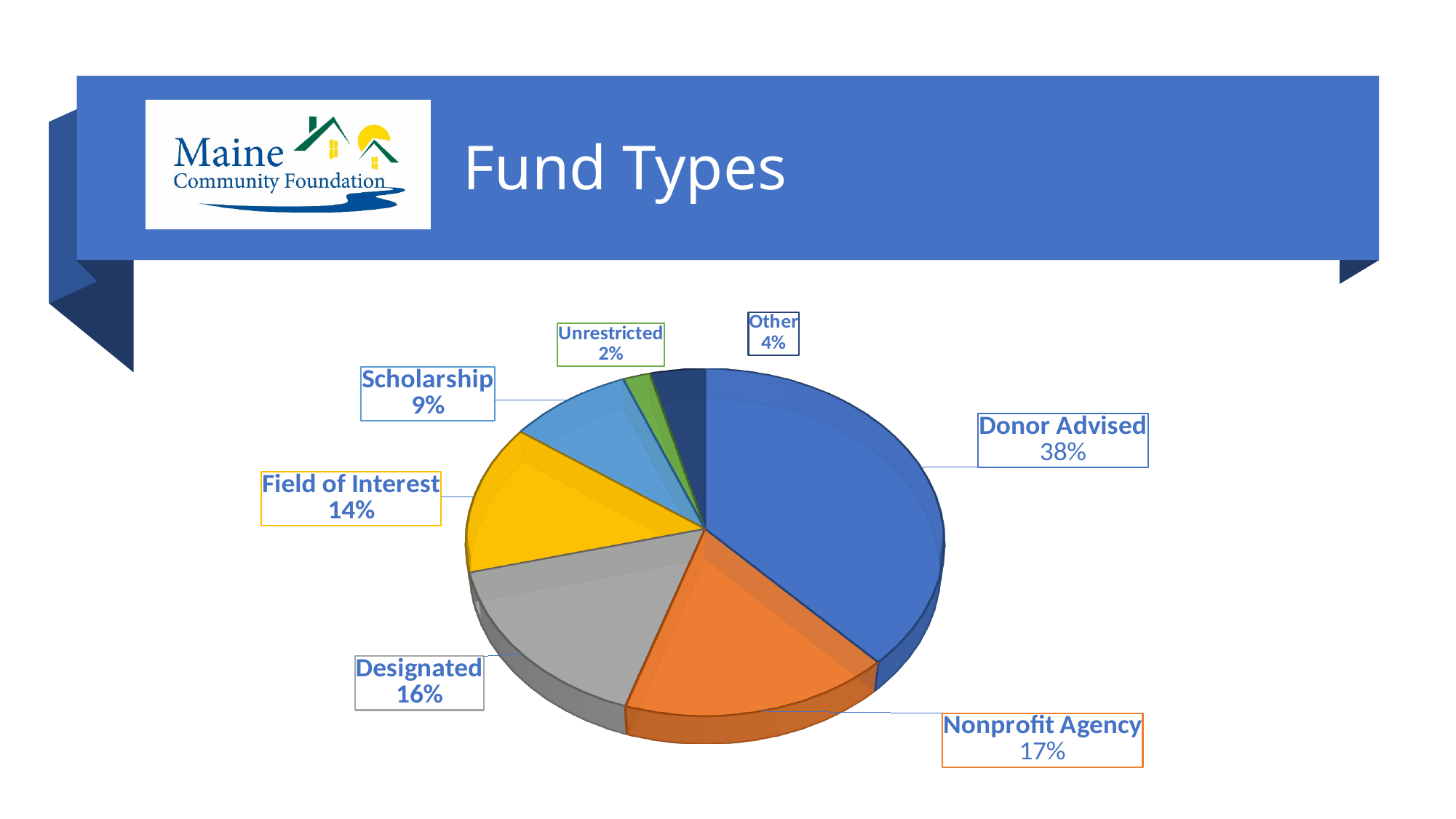
What share of fund types is Designated? 16% How many fund types (slices) are shown in the pie chart? 7 Which fund type has the smallest share of the pie? Unrestricted What share of fund types is Field of Interest? 14% What kind of chart is shown on the slide? pie chart What share of fund types is Unrestricted? 2% Which is larger, the share for Scholarship or the share for Other? Scholarship Which fund type has the largest share of the pie? Donor Advised What is the difference in percentage points between Donor Advised and Nonprofit Agency? 21 What is the title of the slide containing the pie chart? Fund Types What is the combined share of Designated and Field of Interest? 30% What share of fund types is Donor Advised? 38%